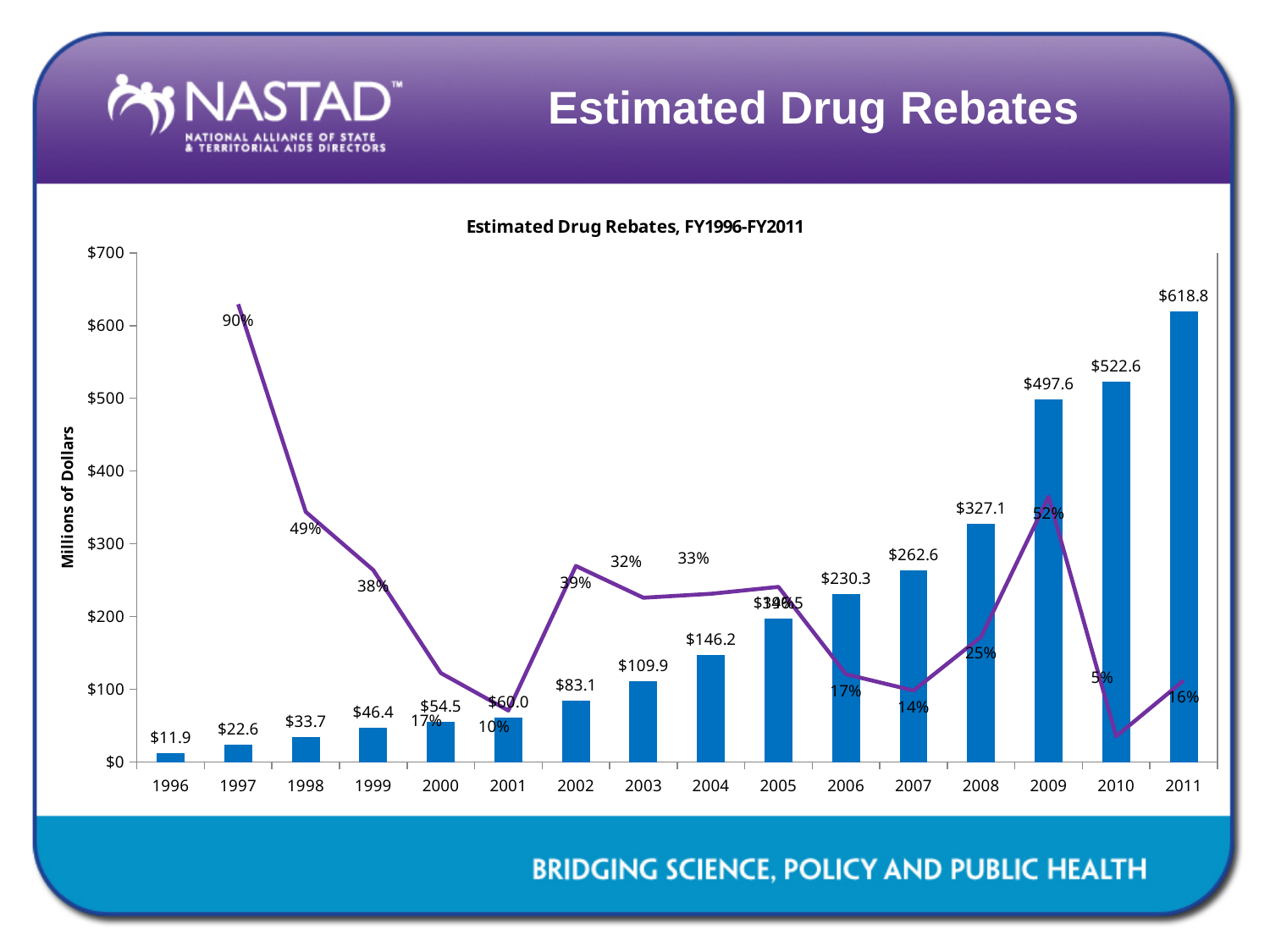
Do the bar values generally rise or fall from 1996 to 2011? rise Which is larger, the estimated drug rebate for 2008 or for 2007? 2008 What percentage is shown on the line for 2010? 5% How many years are shown on the x axis? 16 What is the estimated drug rebate value for 1996? $11.9 What percentage is shown on the line for 1997? 90% What is the difference between the 2011 and 2010 estimated drug rebate values? $96.2 Which year has the highest estimated drug rebate bar? 2011 What is the label on the y axis? Millions of Dollars What is the estimated drug rebate value for 2011? $618.8 Which year has the lowest estimated drug rebate bar? 1996 What is the estimated drug rebate value for 2003? $109.9